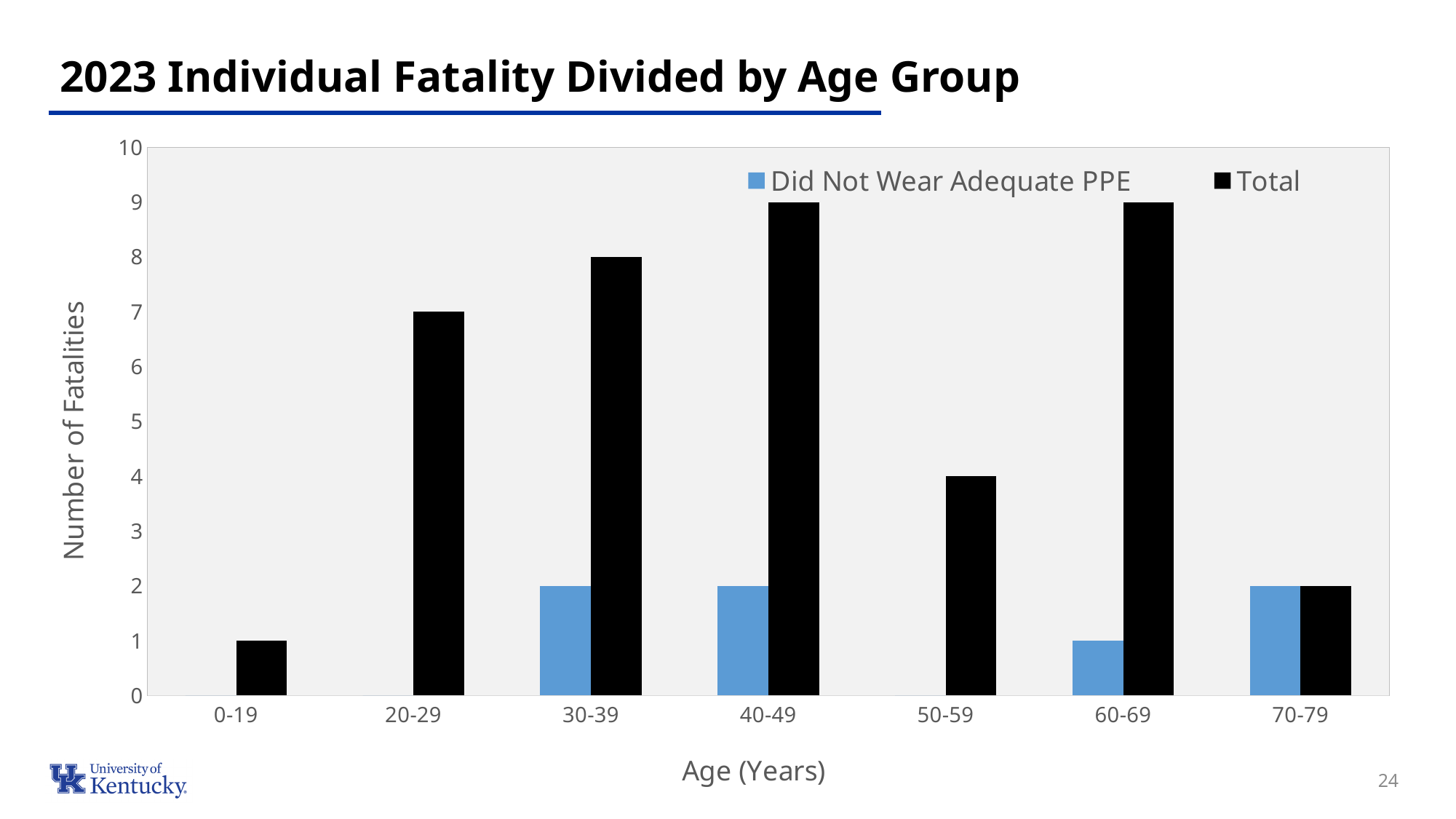
What kind of chart is shown on the slide? Bar chart What is the difference between the Total and the Did Not Wear Adequate PPE values for the 40-49 age group? 7 What is the Did Not Wear Adequate PPE value for the 30-39 age group? 2 What is the Total number of fatalities for the 20-29 age group? 7 How many series does the legend list? 2 Which is larger, the Total for the 30-39 age group or the Total for the 20-29 age group? 30-39 What is the Total number of fatalities for the 50-59 age group? 4 What is the label of the y axis? Number of Fatalities What is the Did Not Wear Adequate PPE value for the 60-69 age group? 1 How many age groups are shown on the x axis? 7 Which age group has the lowest Total number of fatalities? 0-19 Is the Total value for the 60-69 age group greater or less than 5? greater